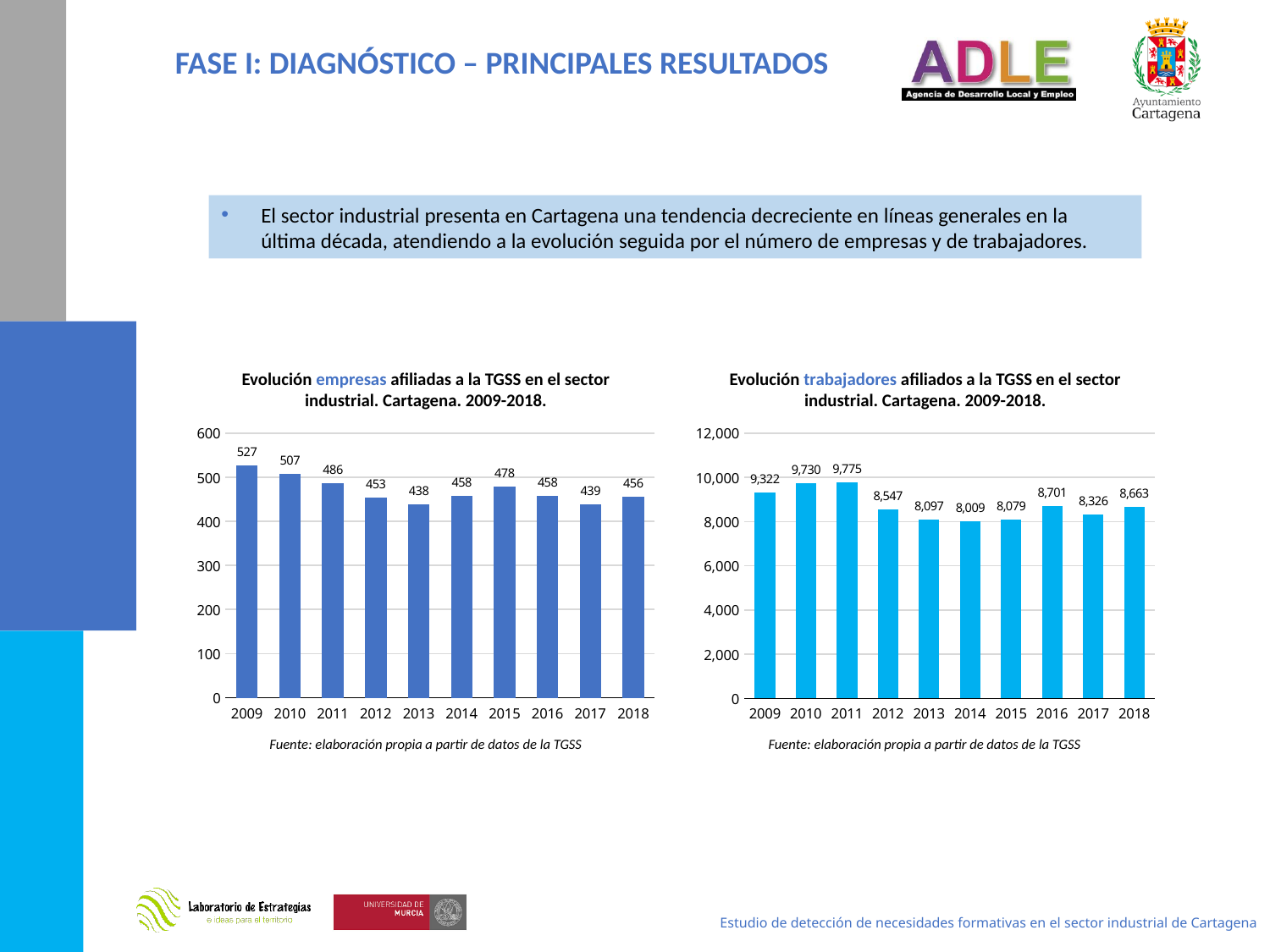
In the left chart (Evolución empresas afiliadas a la TGSS), what is the value for 2009? 527 In the left chart (Evolución empresas afiliadas a la TGSS), what is the difference between the values for 2009 and 2018? 71 In the right chart (Evolución trabajadores afiliados a la TGSS), what is the value for 2014? 8,009 In the left chart (Evolución empresas afiliadas a la TGSS), do the values generally rise or fall from 2009 to 2013? fall In the right chart (Evolución trabajadores afiliados a la TGSS), what is the value for 2011? 9,775 In the right chart (Evolución trabajadores afiliados a la TGSS), what is the difference between the values for 2010 and 2012? 1,183 In the left chart (Evolución empresas afiliadas a la TGSS), which year has the lowest value? 2013 What kind of chart is the right chart (Evolución trabajadores afiliados a la TGSS)? bar chart In the left chart (Evolución empresas afiliadas a la TGSS), how many years are shown on the x axis? 10 In the left chart (Evolución empresas afiliadas a la TGSS), what is the value for 2015? 478 In the right chart (Evolución trabajadores afiliados a la TGSS), which is larger, the value for 2016 or the value for 2017? 2016 In the right chart (Evolución trabajadores afiliados a la TGSS), which year has the highest value? 2011